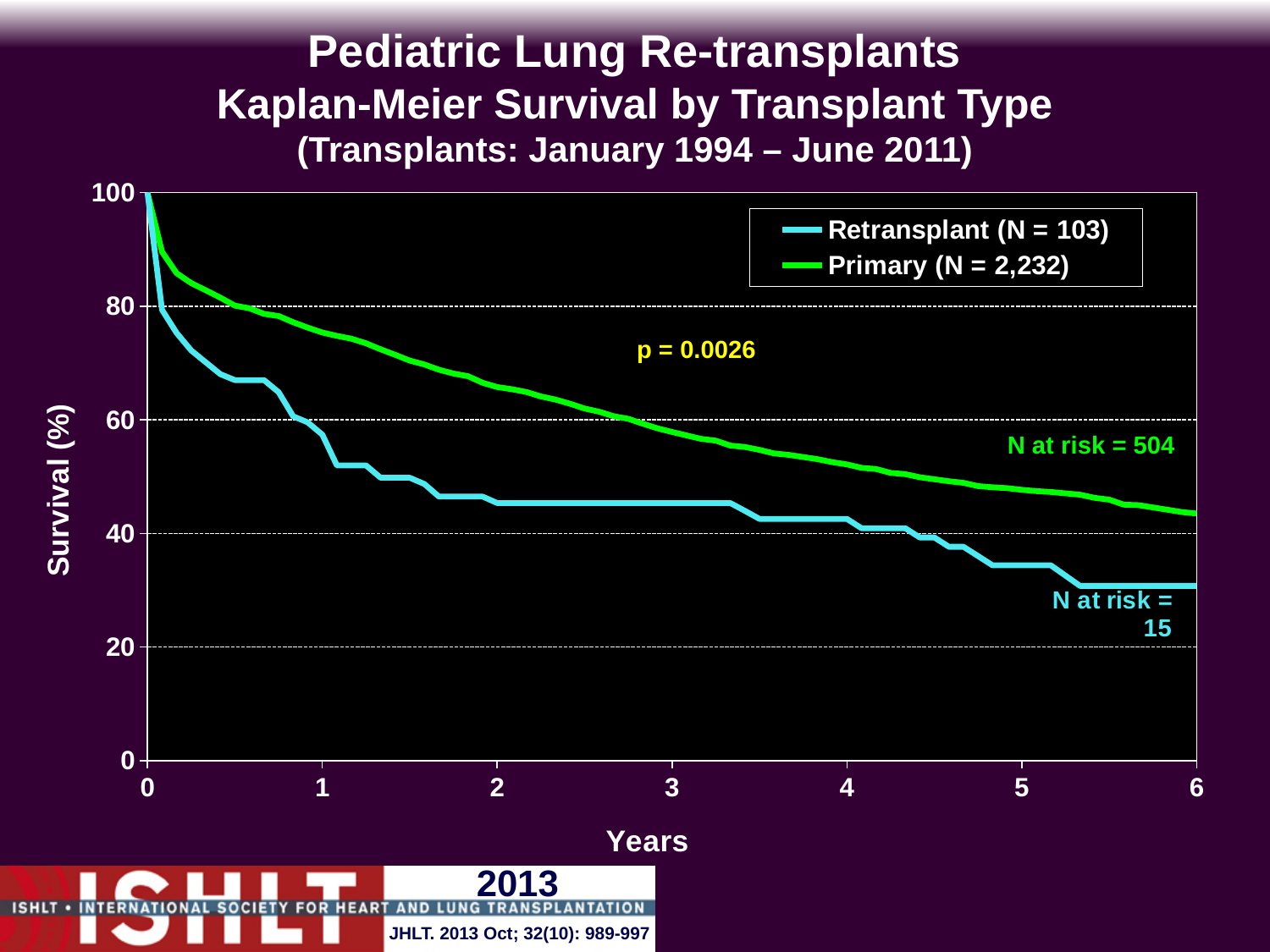
Is the survival for the Retransplant group at 6 years greater or less than 40%? less What is the N at risk for the Retransplant group at the end of follow-up? 15 At 3 years, which group has higher survival, Retransplant or Primary? Primary What kind of chart is shown on the slide? line chart Do the survival curves rise or fall as years increase? fall What is the N at risk for the Primary group at the end of follow-up? 504 What is the N for the Retransplant group shown in the legend? 103 What is the p-value shown on the chart? p = 0.0026 Is the survival for the Primary group at 6 years greater or less than 40%? greater What is the N for the Primary group shown in the legend? 2,232 Is the survival for the Primary group at 1 year greater or less than 80%? less How many series does the legend list? 2